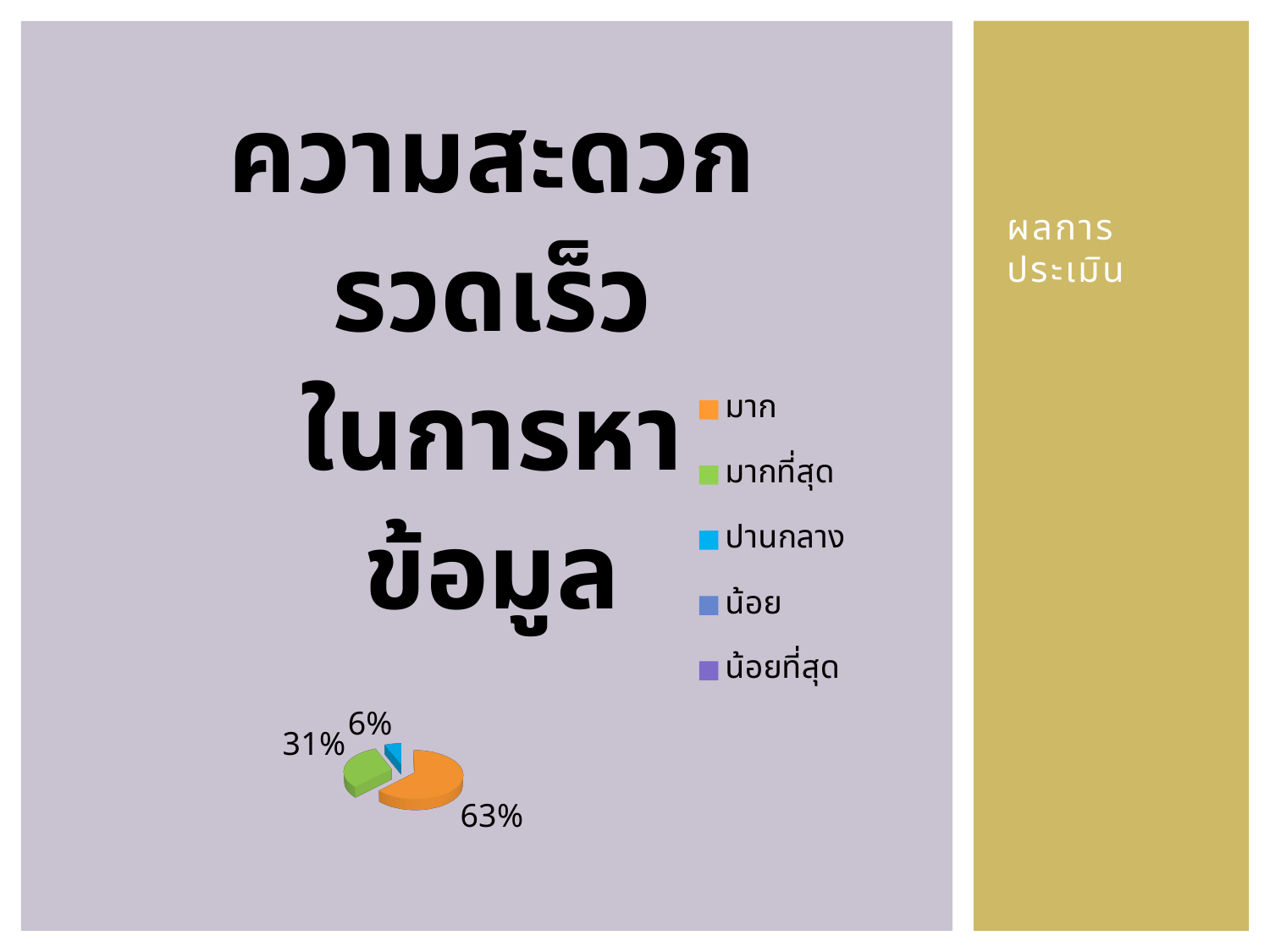
What kind of chart is shown on the slide? pie chart What is the difference in percentage points between the มาก slice and the มากที่สุด slice? 32 How many slices have a percentage label on the pie? 3 Which of the labelled slices is the smallest? ปานกลาง Which slice is larger, มากที่สุด or ปานกลาง? มากที่สุด How many entries does the legend list? 5 What percentage is shown for the มาก slice? 63% What is the title of the chart? ความสะดวกรวดเร็วในการหาข้อมูล What percentage is shown for the ปานกลาง slice? 6% What percentage is shown for the มากที่สุด slice? 31% Which category has the largest slice of the pie? มาก What colour is used for the มาก category in the legend? orange